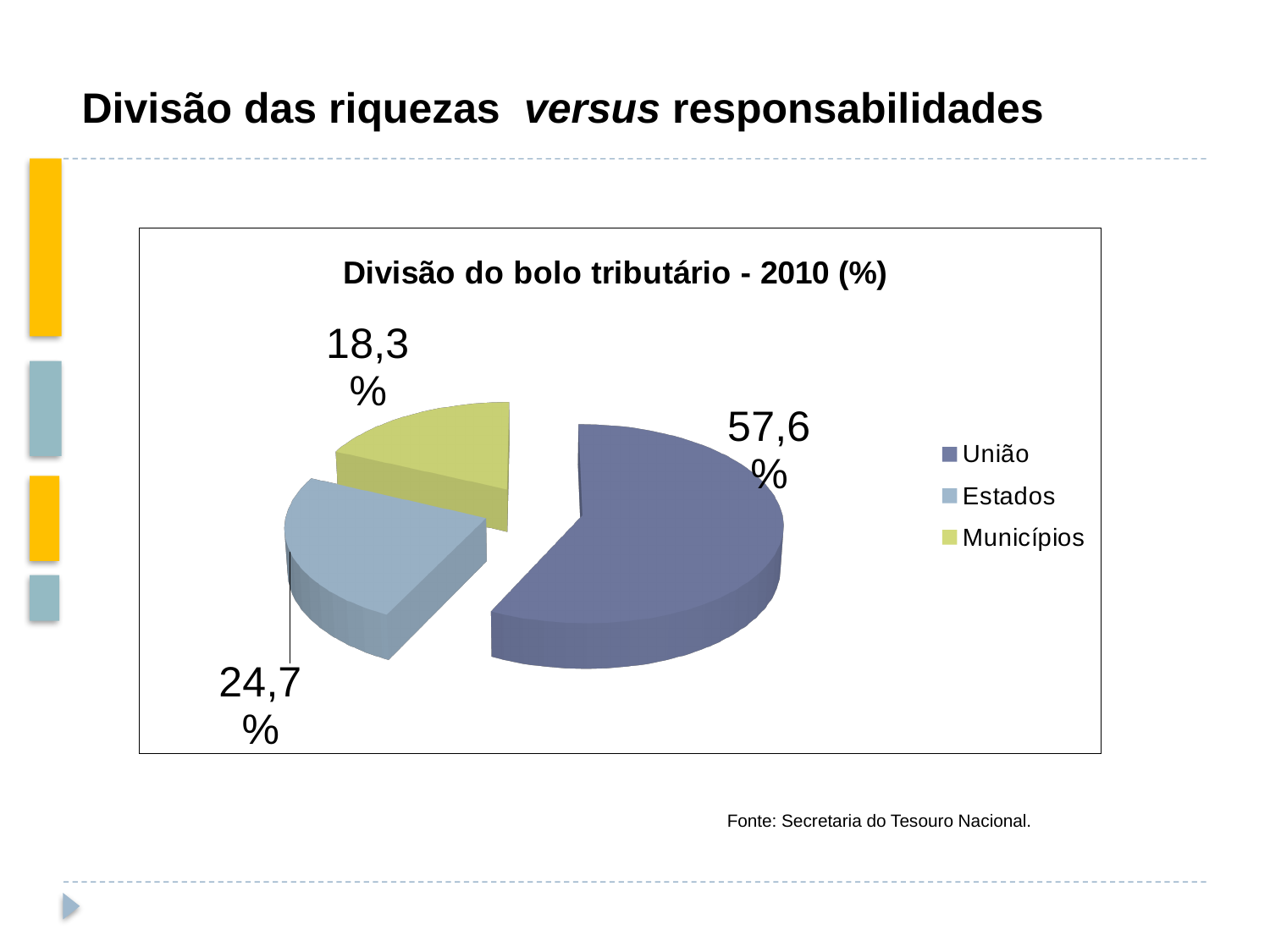
What is the title of the chart? Divisão do bolo tributário - 2010 (%) What share of the pie does Municípios hold? 18,3% What is the difference in percentage points between the Estados and Municípios slices? 6,4 How many slices does the pie chart have? 3 What kind of chart is shown on the slide? Pie chart What share of the pie does Estados hold? 24,7% What share of the pie does União hold? 57,6% Which category has the largest slice of the pie? União Which category is shown in the yellow-green colour in the legend? Municípios Which category has the smallest slice of the pie? Municípios What is the difference in percentage points between the União and Estados slices? 32,9 Which is larger, the slice for Estados or the slice for Municípios? Estados